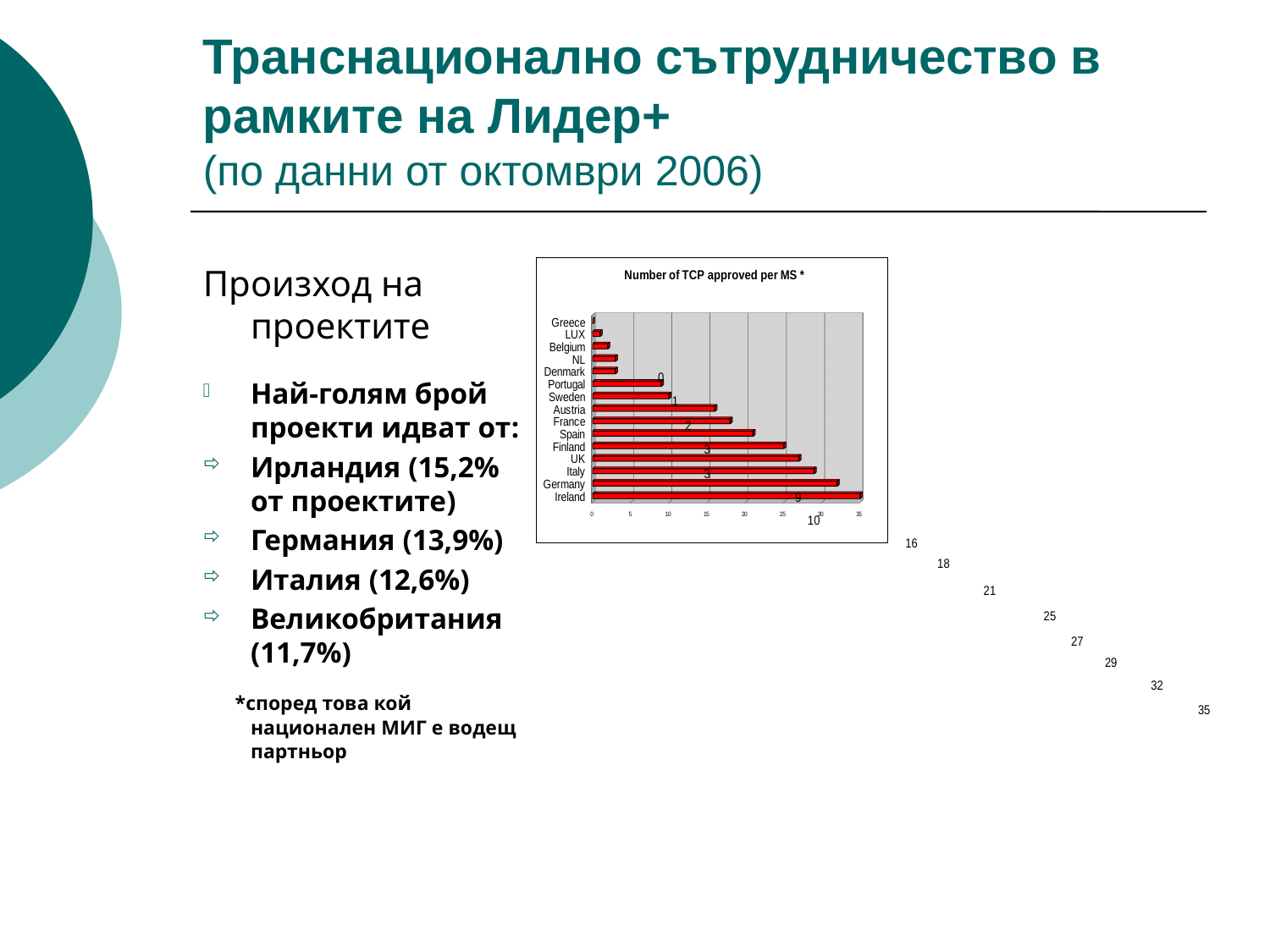
Is the value for UK greater or less than 25? greater Which has a larger value, Spain or Sweden? Spain What kind of chart is shown on the slide? bar chart Is the value for Ireland greater or less than 30? greater Which country has the lowest number of TCP approved in the chart? Greece Which country has the highest number of TCP approved in the chart? Ireland How many countries (categories) are plotted in the chart? 15 What is the title of the chart? Number of TCP approved per MS * Is the value for France greater or less than 20? less Which has a larger value, Ireland or Germany? Ireland Going down the category axis from Greece to Ireland, do the bars get longer or shorter? longer